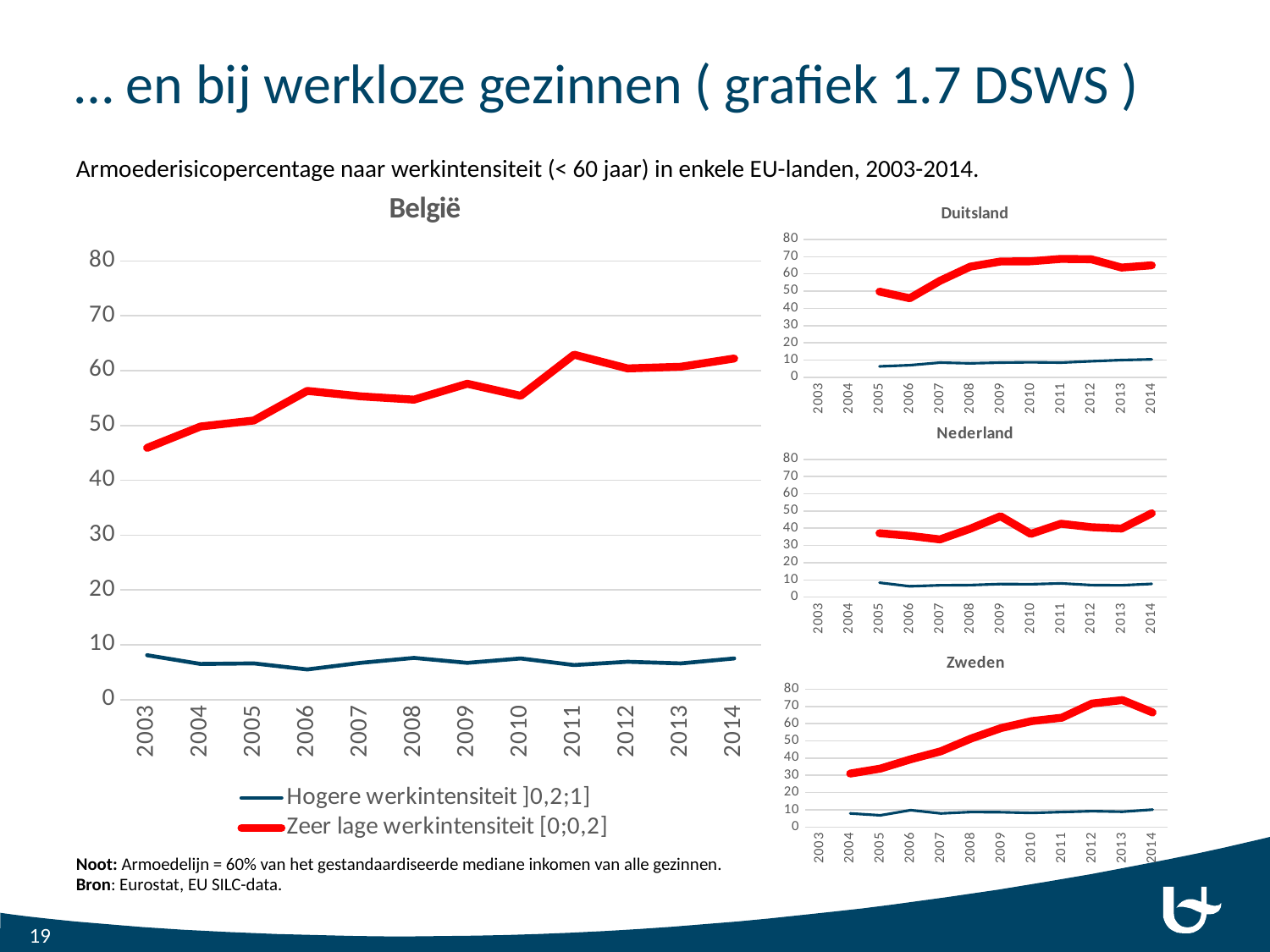
In the Duitsland chart, which year has the lowest value for the Zeer lage werkintensiteit line? 2006 In the België chart, which year has the lowest value for Zeer lage werkintensiteit? 2003 In the Zweden chart, which year has the highest value for the Zeer lage werkintensiteit line? 2013 In the Zweden chart, is the value for the Zeer lage werkintensiteit line in 2004 greater or less than 40? less In the Nederland chart, is the value for the Zeer lage werkintensiteit line in 2014 greater or less than 40? greater In the België chart, is the value for Zeer lage werkintensiteit in 2003 greater or less than 50? less What kind of chart is the België chart? line chart In the België chart, does the Zeer lage werkintensiteit line generally rise or fall from 2003 to 2014? rise In the België chart, which colour is used for the Zeer lage werkintensiteit [0;0,2] line? red How many years are shown on the x axis of the België chart? 12 How many series does the legend of the België chart list? 2